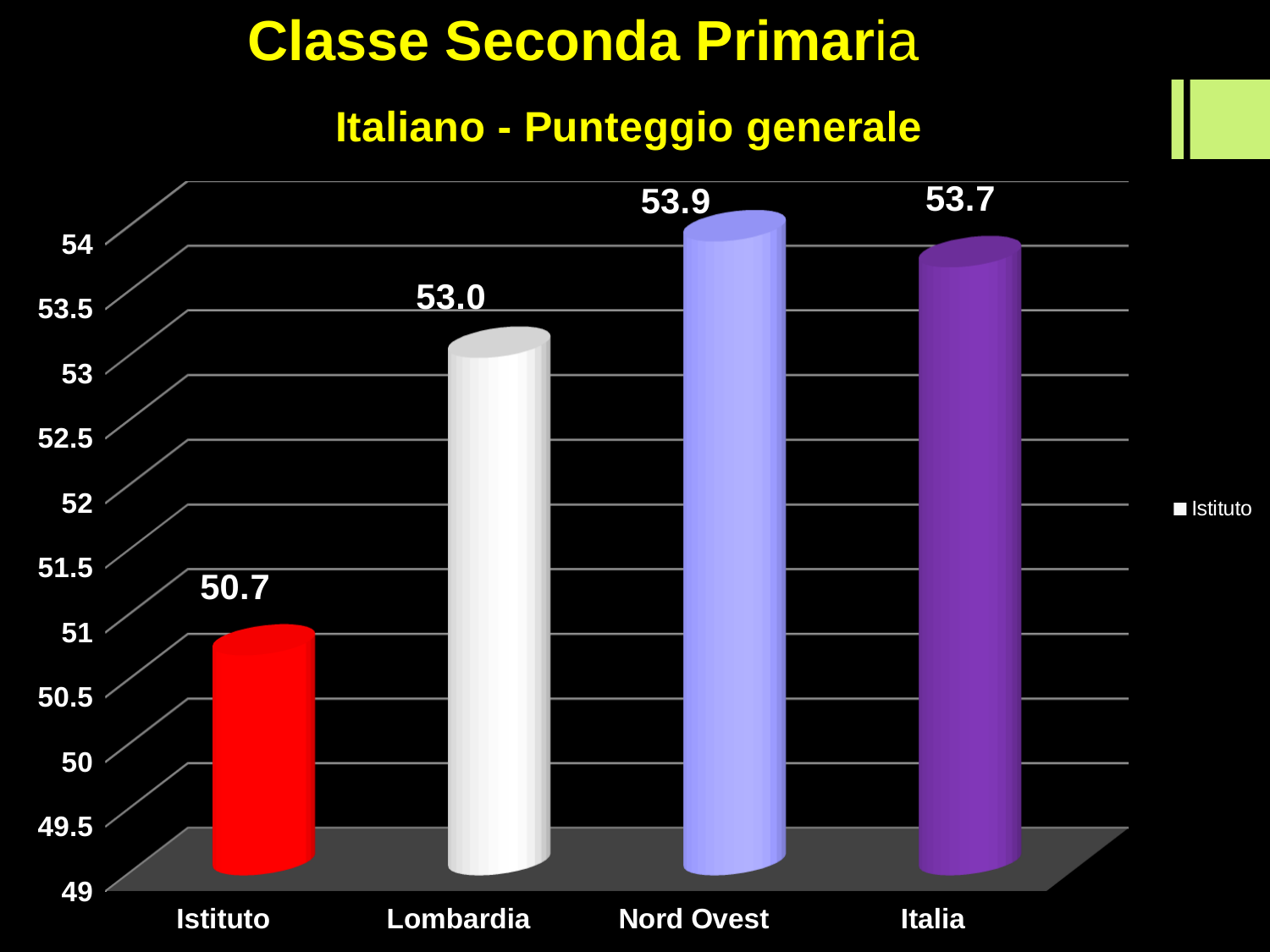
What is the value for Istituto? 50.7 Which is larger, the value for Lombardia or the value for Italia? Italia What is the difference between the values for Nord Ovest and Istituto? 3.2 Is the value for Istituto greater or less than 51? less What kind of chart is shown on the slide? bar chart What is the value for Nord Ovest? 53.9 Which category has the lowest value? Istituto How many categories are shown on the x axis? 4 What is the title of the chart? Italiano - Punteggio generale What is the value for Italia? 53.7 Which category has the highest value? Nord Ovest What is the value for Lombardia? 53.0